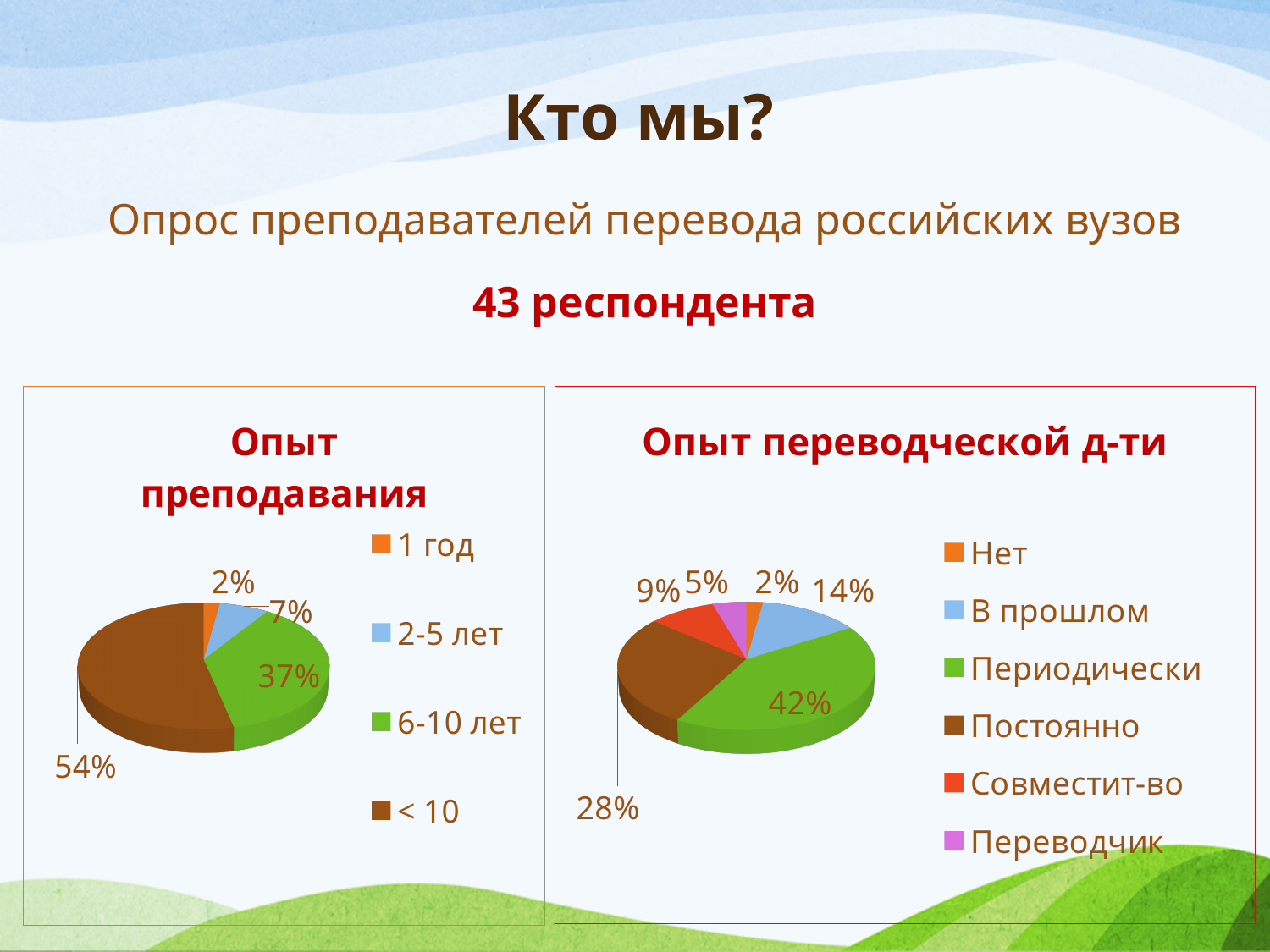
In the chart titled "Опыт преподавания", what share is labelled for "6-10 лет"? 37% In the chart titled "Опыт переводческой д-ти", what is the difference between the shares for "Периодически" and "Постоянно"? 14% In the chart titled "Опыт переводческой д-ти", what share is labelled for "Постоянно"? 28% In the chart titled "Опыт преподавания", how many categories does the legend list? 4 In the chart titled "Опыт переводческой д-ти", which category has the largest slice? Периодически In the chart titled "Опыт переводческой д-ти", what share is labelled for "Периодически"? 42% In the chart titled "Опыт переводческой д-ти", how many categories does the legend list? 6 In the chart titled "Опыт преподавания", which category has the smallest slice? 1 год In the chart titled "Опыт преподавания", which category has the largest slice? < 10 What type of chart is the chart titled "Опыт переводческой д-ти"? Pie chart In the chart titled "Опыт преподавания", what share is labelled for "< 10"? 54% In the chart titled "Опыт переводческой д-ти", what share is labelled for "В прошлом"? 14%